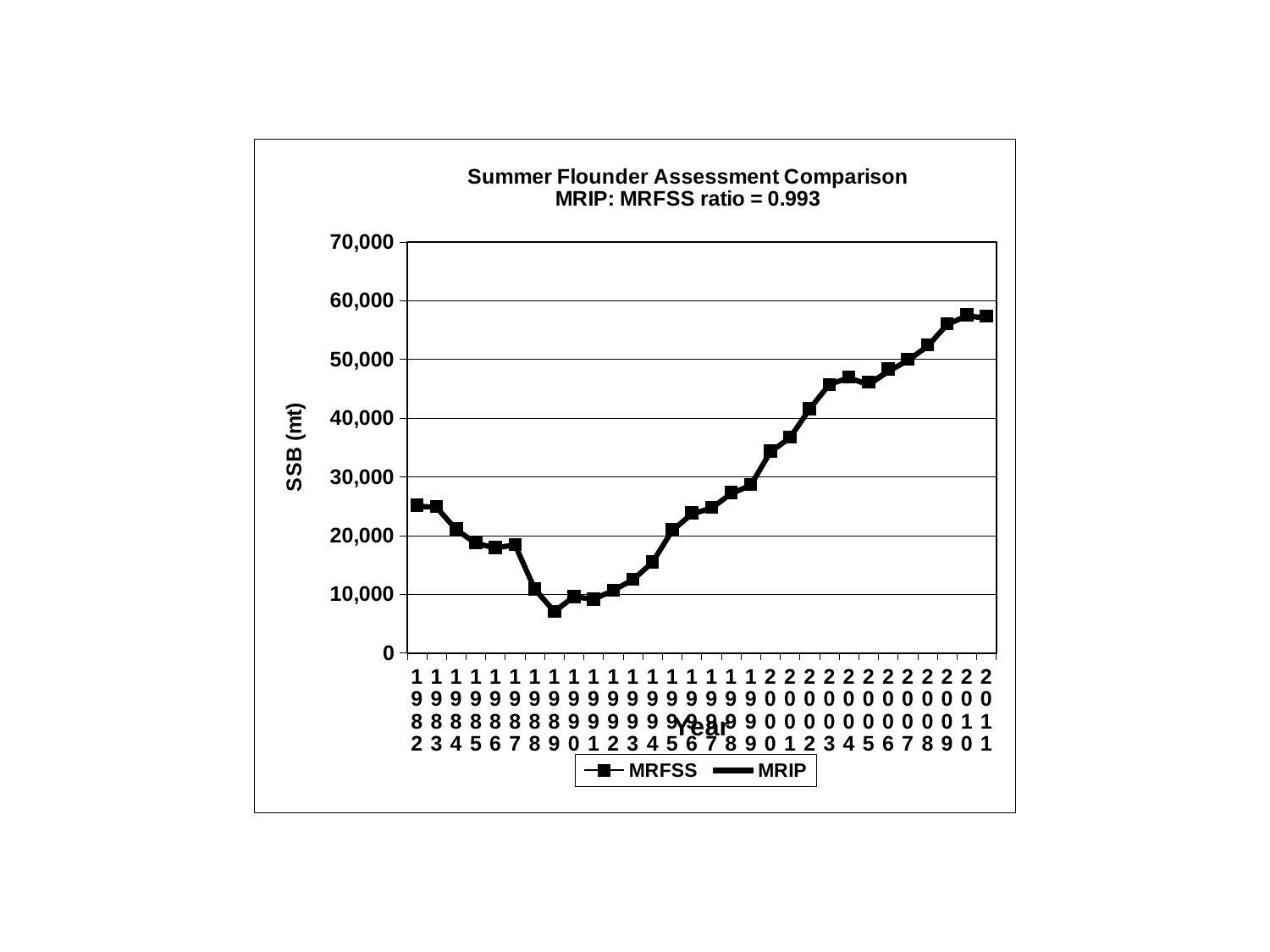
Which year has a larger MRFSS SSB value, 1982 or 1989? 1982 Is the MRFSS value for 2010 greater or less than 50,000? greater In which year is the MRFSS SSB value lowest? 1989 Is the MRFSS value for 1989 greater or less than 10,000? less How many years are plotted along the x axis? 30 Which two series are listed in the legend? MRFSS and MRIP What is the MRIP: MRFSS ratio stated in the chart title? 0.993 Is the MRFSS value for 2000 greater or less than 40,000? less What kind of chart is shown on the slide? line chart How many series does the legend list? 2 Do the SSB values generally rise or fall from 1989 to 2010? rise